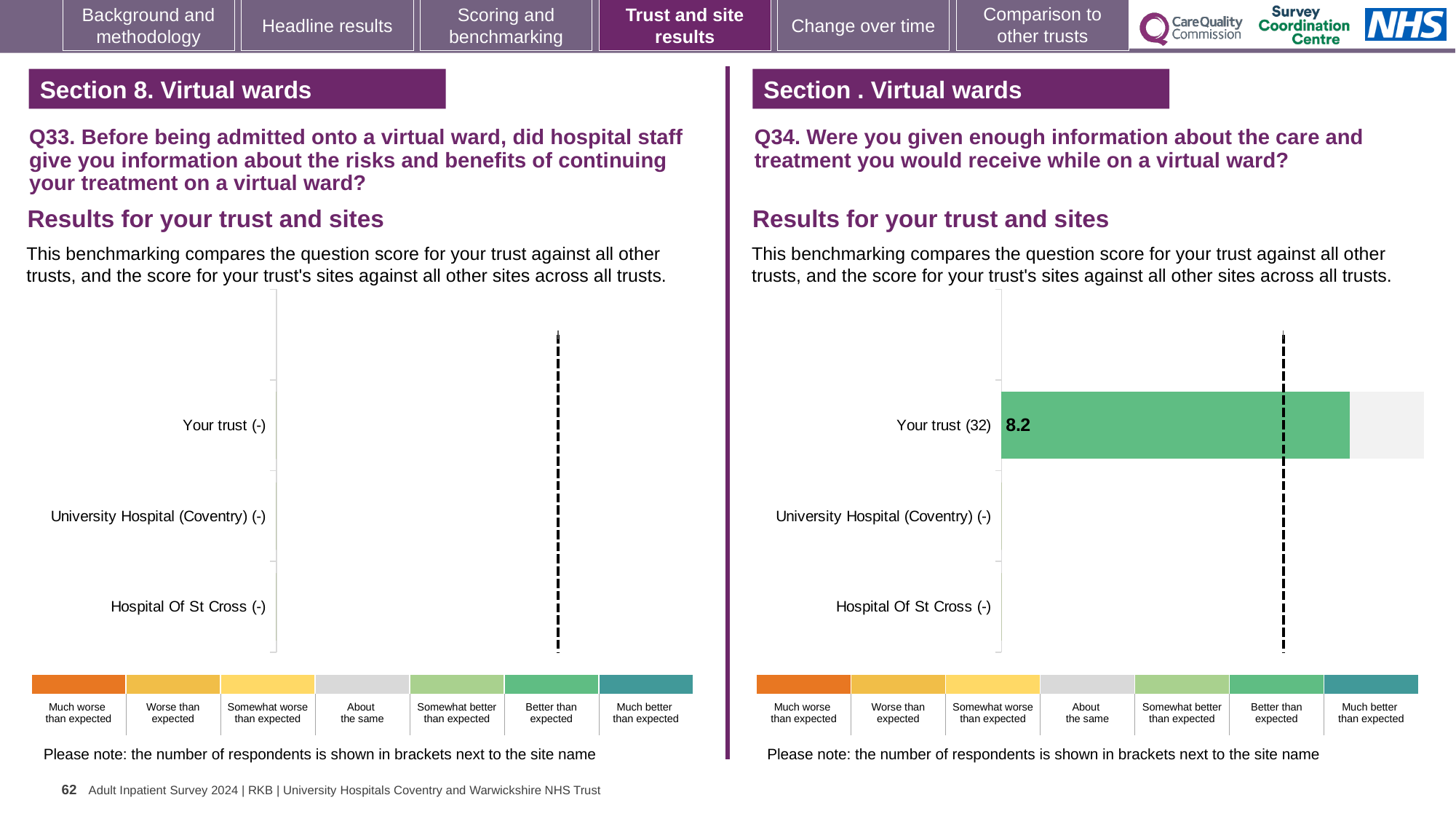
How many categories are listed on the vertical axis of the Q33 chart on the left? 3 In the Q34 chart on the right, what is the label of the middle category on the vertical axis? University Hospital (Coventry) (-) In the Q34 chart on the right, what is the label of the bottom category on the vertical axis? Hospital Of St Cross (-) In the Q34 chart on the right, which benchmarking band does the colour of the Your trust bar correspond to? Better than expected In the Q33 chart on the left, how many categories have a plotted bar? 0 In the Q34 chart on the right, what is the score shown for Your trust? 8.2 In the Q34 chart on the right, which category has a plotted bar? Your trust (32) In the Q34 chart on the right, how many respondents are shown in brackets next to Your trust? 32 What kind of chart is the Q34 chart on the right? Bar chart How many categories are listed on the vertical axis of the Q34 chart on the right? 3